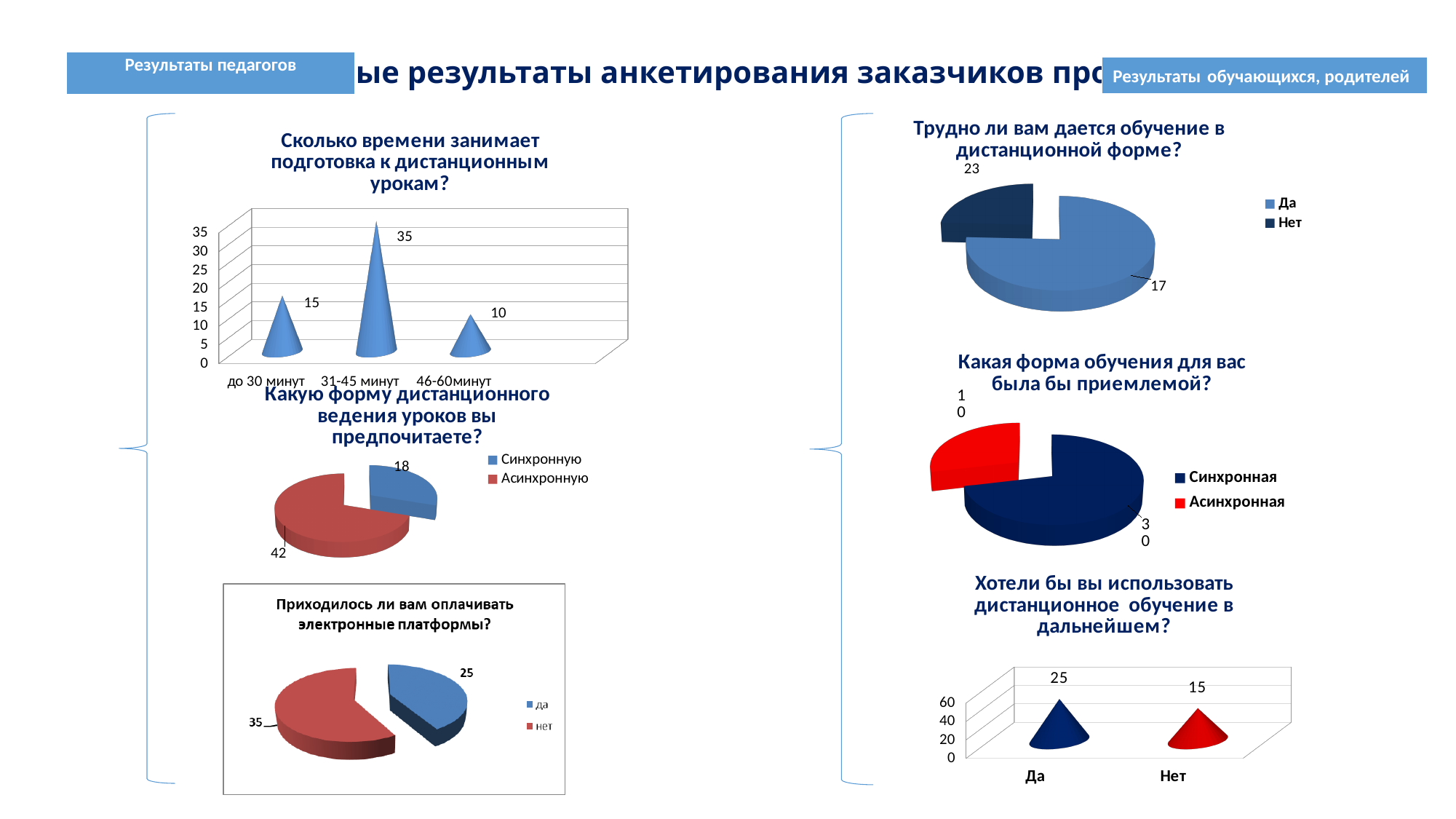
In the pie chart 'Какую форму дистанционного ведения уроков вы предпочитаете?', what is the value for 'Асинхронную'? 42 In the pie chart 'Приходилось ли вам оплачивать электронные платформы?', what is the value for 'нет'? 35 In the pie chart 'Какую форму дистанционного ведения уроков вы предпочитаете?', what share of the total does 'Синхронную' represent? 30% In the pie chart 'Приходилось ли вам оплачивать электронные платформы?', which is larger, 'да' or 'нет'? нет In the chart 'Сколько времени занимает подготовка к дистанционным урокам?', which category has the lowest value? 46-60 минут In the chart 'Сколько времени занимает подготовка к дистанционным урокам?', what is the difference between the values for '31-45 минут' and 'до 30 минут'? 20 How many categories are shown in the chart 'Сколько времени занимает подготовка к дистанционным урокам?'? 3 In the chart 'Сколько времени занимает подготовка к дистанционным урокам?', what is the value for '31-45 минут'? 35 What type of chart is 'Хотели бы вы использовать дистанционное обучение в дальнейшем?'? Bar chart In the pie chart 'Какая форма обучения для вас была бы приемлемой?', which slice is larger, 'Синхронная' or 'Асинхронная'? Синхронная